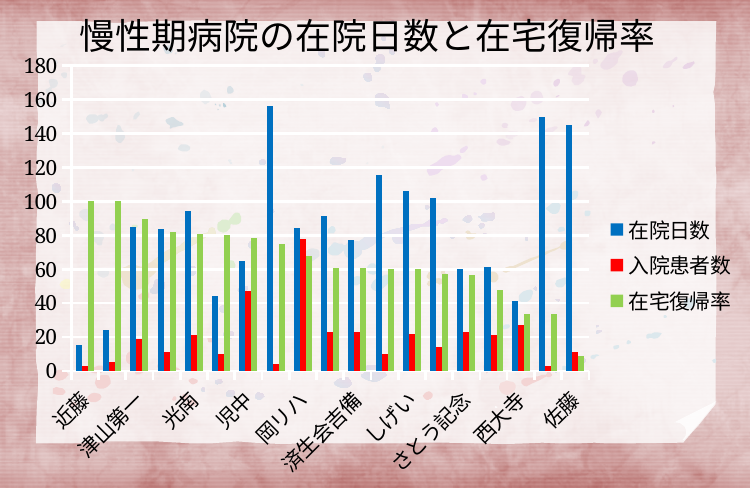
Is the 在院日数 value for 津山第一 greater or less than 60? greater Is the 在院日数 value for 佐藤 greater or less than 120? greater Which has the larger 在院日数, 近藤 or 佐藤? 佐藤 Is the 在院日数 value for 近藤 greater or less than 40? less What is the title of the chart? 慢性期病院の在院日数と在宅復帰率 How many series does the legend list? 3 Which is larger for 近藤, 在院日数 or 在宅復帰率? 在宅復帰率 Which series is shown in green in the legend? 在宅復帰率 What kind of chart is shown on the slide? bar chart Which is larger for 佐藤, 在院日数 or 在宅復帰率? 在院日数